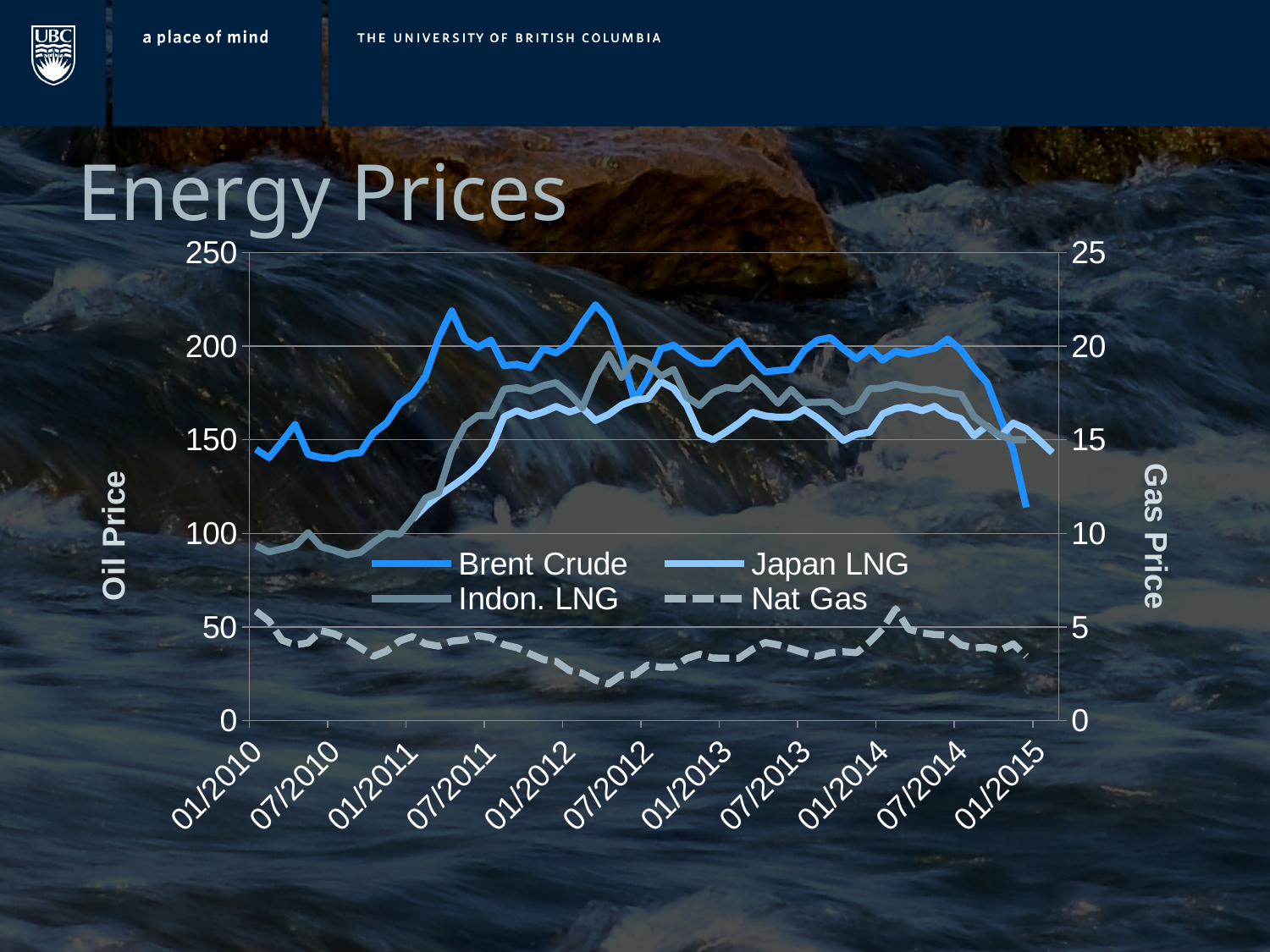
On the left Oil Price axis, is the Brent Crude value at 01/2010 greater or less than 100? greater Is the Brent Crude value higher at 01/2010 or at 01/2015? 01/2010 On the left Oil Price axis, is the Brent Crude value at 01/2015 greater or less than 150? less Which series is drawn as a dashed line? Nat Gas What is the title of the chart? Energy Prices What type of chart is shown on the slide? Line chart How many date labels are shown along the x axis? 11 On the right Gas Price axis, is the Nat Gas value at 07/2012 greater or less than 5? less Does the Brent Crude line rise or fall between 07/2014 and 01/2015? Falls Does the Brent Crude line rise or fall between 01/2010 and 07/2011? Rises How many series does the legend list? 4